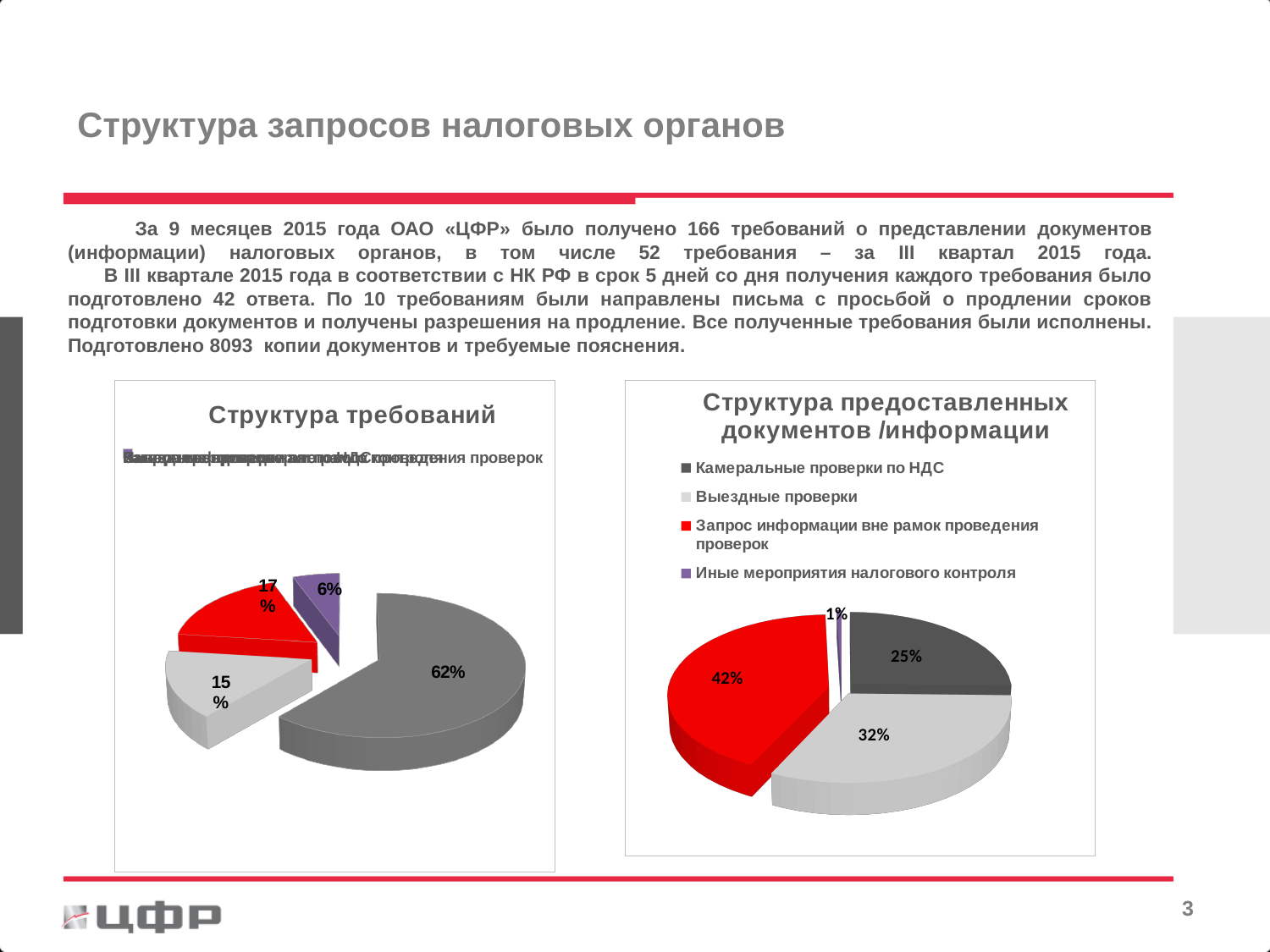
In the chart titled "Структура предоставленных документов /информации", which category has the largest slice? Запрос информации вне рамок проведения проверок In the chart titled "Структура предоставленных документов /информации", what share is shown for "Выездные проверки"? 32% What kind of chart is the chart titled "Структура предоставленных документов /информации"? pie chart In the chart titled "Структура предоставленных документов /информации", how many percentage points larger is "Запрос информации вне рамок проведения проверок" than "Камеральные проверки по НДС"? 17 How many slices does the pie chart titled "Структура требований" have? 4 In the chart titled "Структура предоставленных документов /информации", what share is shown for "Камеральные проверки по НДС"? 25% In the chart titled "Структура предоставленных документов /информации", what share is shown for "Иные мероприятия налогового контроля"? 1% In the chart titled "Структура требований", what is the largest percentage shown on a slice? 62% In the chart titled "Структура предоставленных документов /информации", what share is shown for "Запрос информации вне рамок проведения проверок"? 42% How many entries does the legend of the chart titled "Структура предоставленных документов /информации" list? 4 In the chart titled "Структура предоставленных документов /информации", which is larger: "Выездные проверки" or "Камеральные проверки по НДС"? Выездные проверки In the chart titled "Структура предоставленных документов /информации", which category has the smallest slice? Иные мероприятия налогового контроля